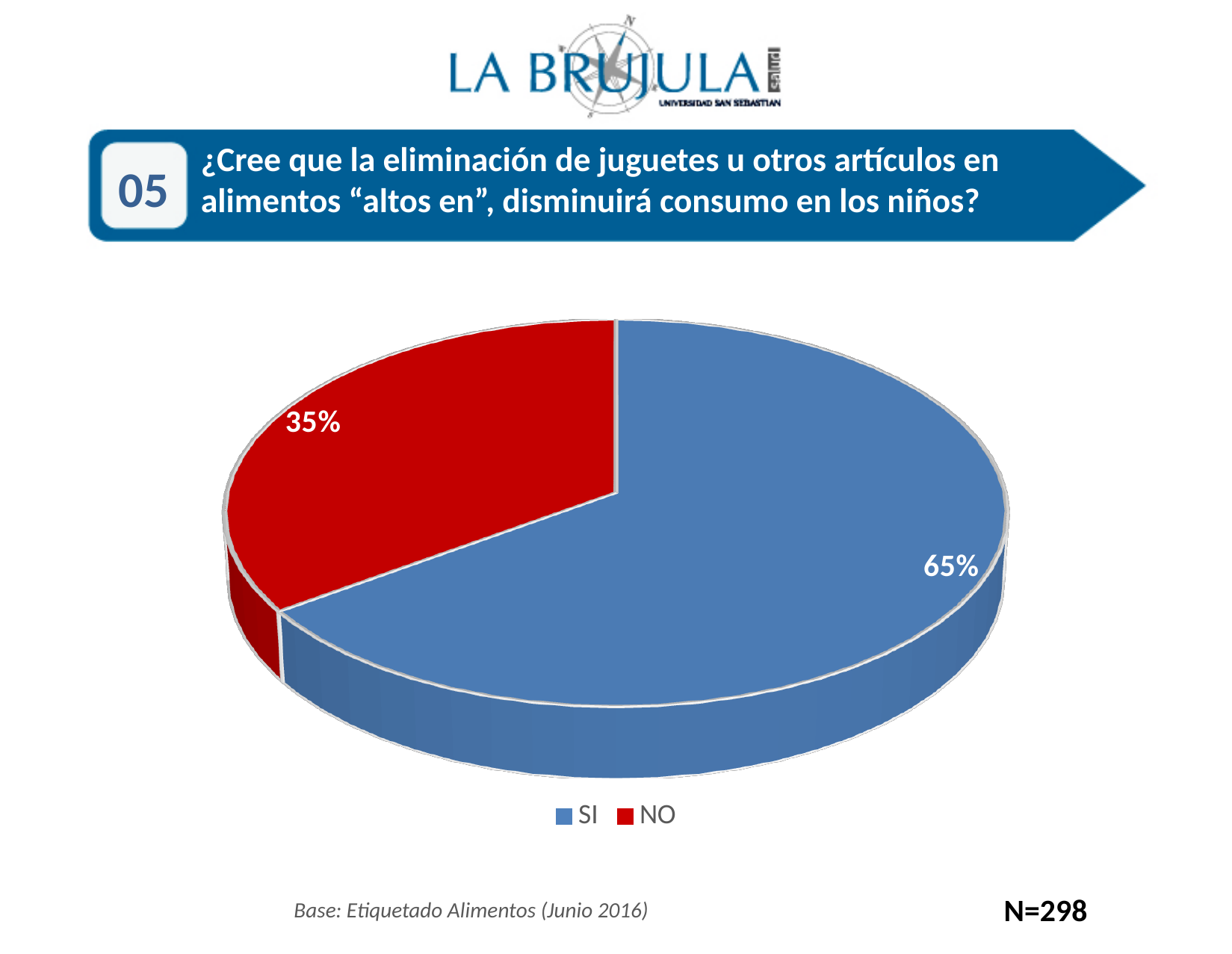
How many entries does the legend list? 2 Which slice is larger, SI or NO? SI Which response has the largest share of the pie? SI What kind of chart is shown on the slide? Pie chart How many slices does the pie chart have? 2 What share of the pie does the NO slice represent? 35% Which response has the smallest share of the pie? NO What colour is the SI slice? Blue What percentage of respondents answered NO? 35% What is the difference in percentage points between the SI and NO slices? 30 What percentage of respondents answered SI? 65% What is the sample size (N) shown on the slide? N=298